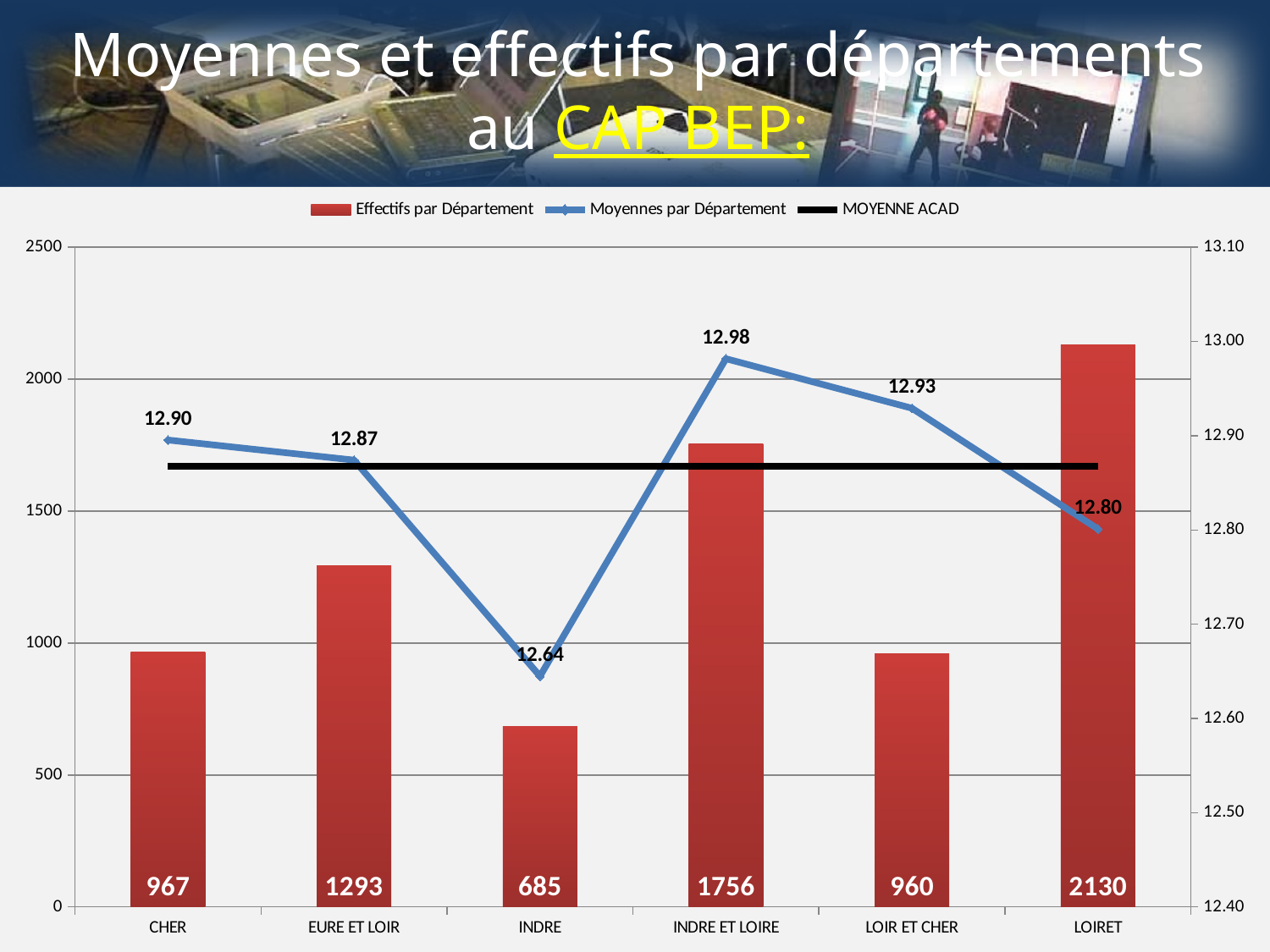
What is the difference in Effectifs par Département between LOIRET and INDRE? 1445 Which has a larger Effectifs par Département, EURE ET LOIR or LOIR ET CHER? EURE ET LOIR Which department has the lowest Moyennes par Département? INDRE Which department has the highest Effectifs par Département? LOIRET What is the Moyennes par Département value for INDRE? 12.64 Is the MOYENNE ACAD line greater or less than 12.90 on the right axis? less What is the Moyennes par Département value for INDRE ET LOIRE? 12.98 What is the value of Effectifs par Département for LOIRET? 2130 How many departments are shown on the x axis? 6 How many series does the legend list? 3 What kind of chart is used for the Effectifs par Département series? bar chart What colour is the MOYENNE ACAD line? black